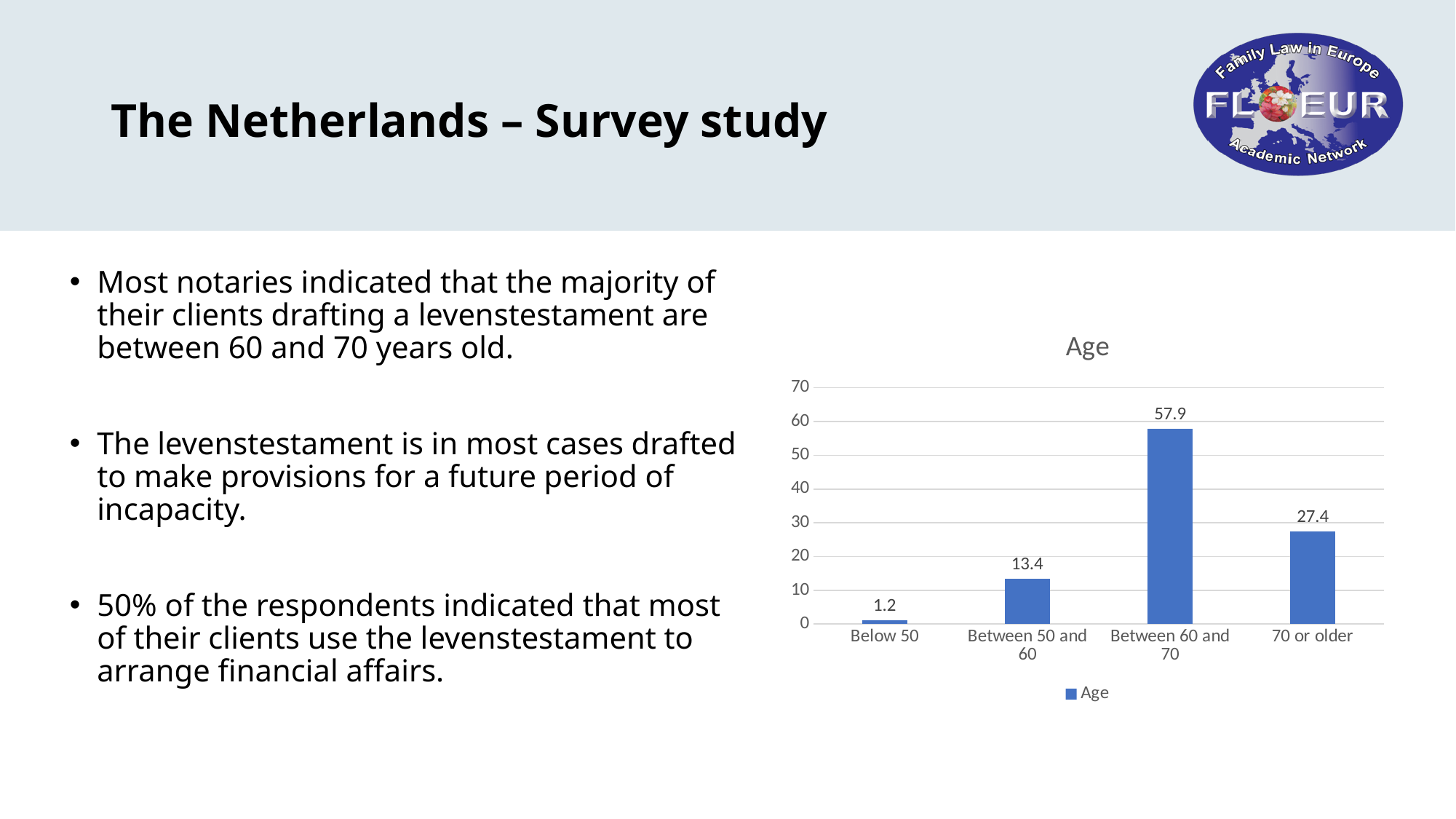
What is the difference between the values for 'Between 60 and 70' and '70 or older'? 30.5 What is the value for the 'Between 60 and 70' category in the Age chart? 57.9 What kind of chart is shown on the slide? Bar chart Which age category has the highest value in the chart? Between 60 and 70 What is the value for the 'Below 50' category in the Age chart? 1.2 Is the value for 'Between 60 and 70' greater or less than 50? greater What is the value for the 'Between 50 and 60' category in the Age chart? 13.4 How many age categories are shown in the chart? 4 Which age category has the lowest value in the chart? Below 50 Which is larger: the value for '70 or older' or the value for 'Between 50 and 60'? 70 or older What is the value for the '70 or older' category in the Age chart? 27.4 What is the title of the chart on the slide? Age